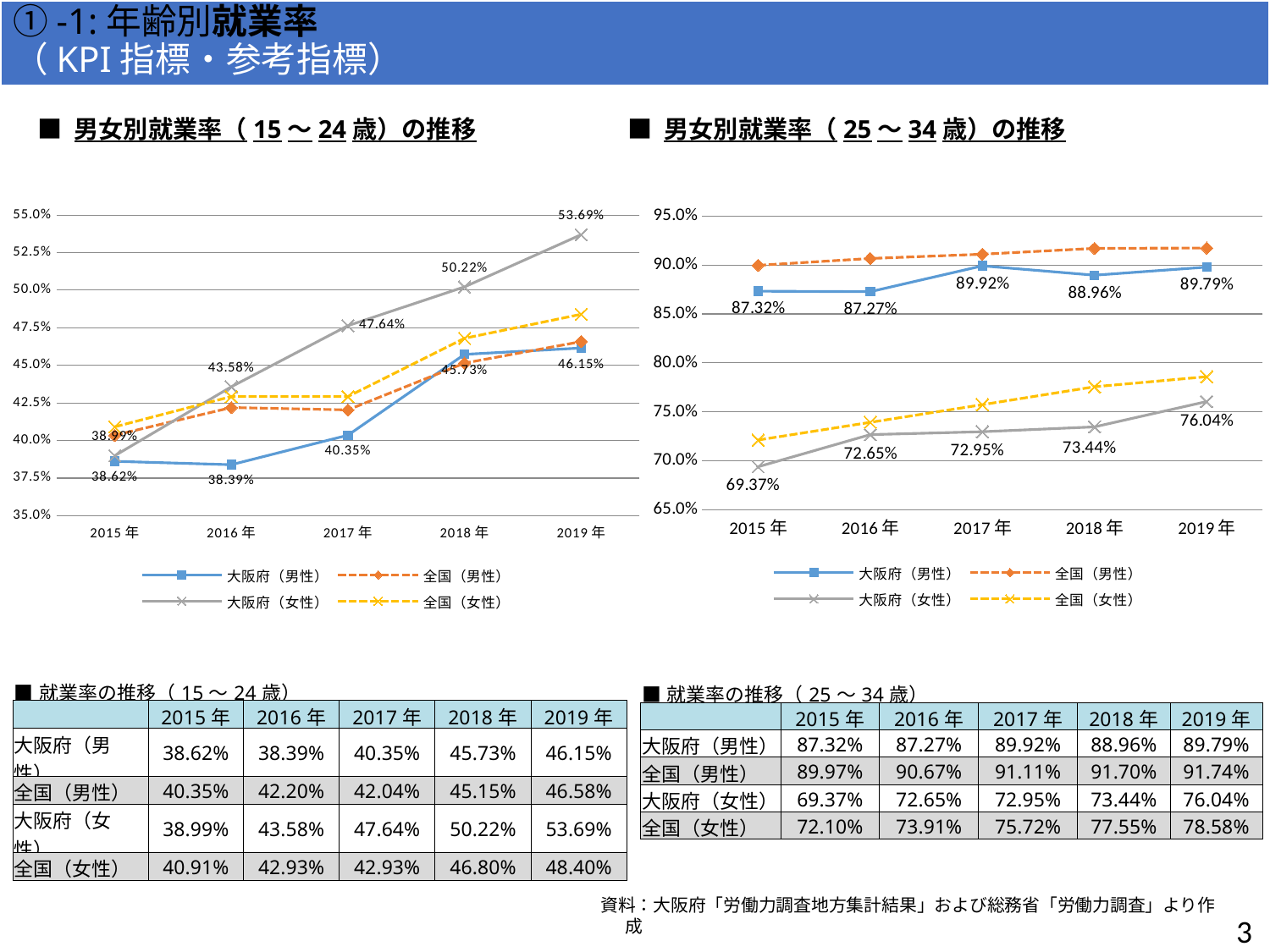
In the 男女別就業率（15～24歳）の推移 chart, which series has the highest value in 2019年? 大阪府（女性） In the 男女別就業率（25～34歳）の推移 chart, what is the value for 大阪府（男性） in 2017年? 89.92% What kind of chart is the 男女別就業率（25～34歳）の推移 chart? line chart In the 男女別就業率（15～24歳）の推移 chart, which year has the lowest value for 大阪府（男性）? 2016年 How many series does the legend of the 男女別就業率（15～24歳）の推移 chart list? 4 In the 男女別就業率（25～34歳）の推移 chart, what is the value for 大阪府（女性） in 2015年? 69.37% In the 男女別就業率（25～34歳）の推移 chart, which is larger in 2018年: 大阪府（男性） or 全国（男性）? 全国（男性） In the 男女別就業率（15～24歳）の推移 chart, what is the value for 大阪府（男性） in 2019年? 46.15% In the 男女別就業率（25～34歳）の推移 chart, is the value for 全国（女性） in 2019年 greater or less than 75.0%? greater In the 男女別就業率（15～24歳）の推移 chart, what is the value for 大阪府（女性） in 2017年? 47.64% In the 男女別就業率（25～34歳）の推移 chart, what is the difference between the 大阪府（女性） values in 2019年 and 2018年? 2.60% In the 男女別就業率（15～24歳）の推移 chart, what is the difference between the 大阪府（女性） values in 2019年 and 2015年? 14.70%